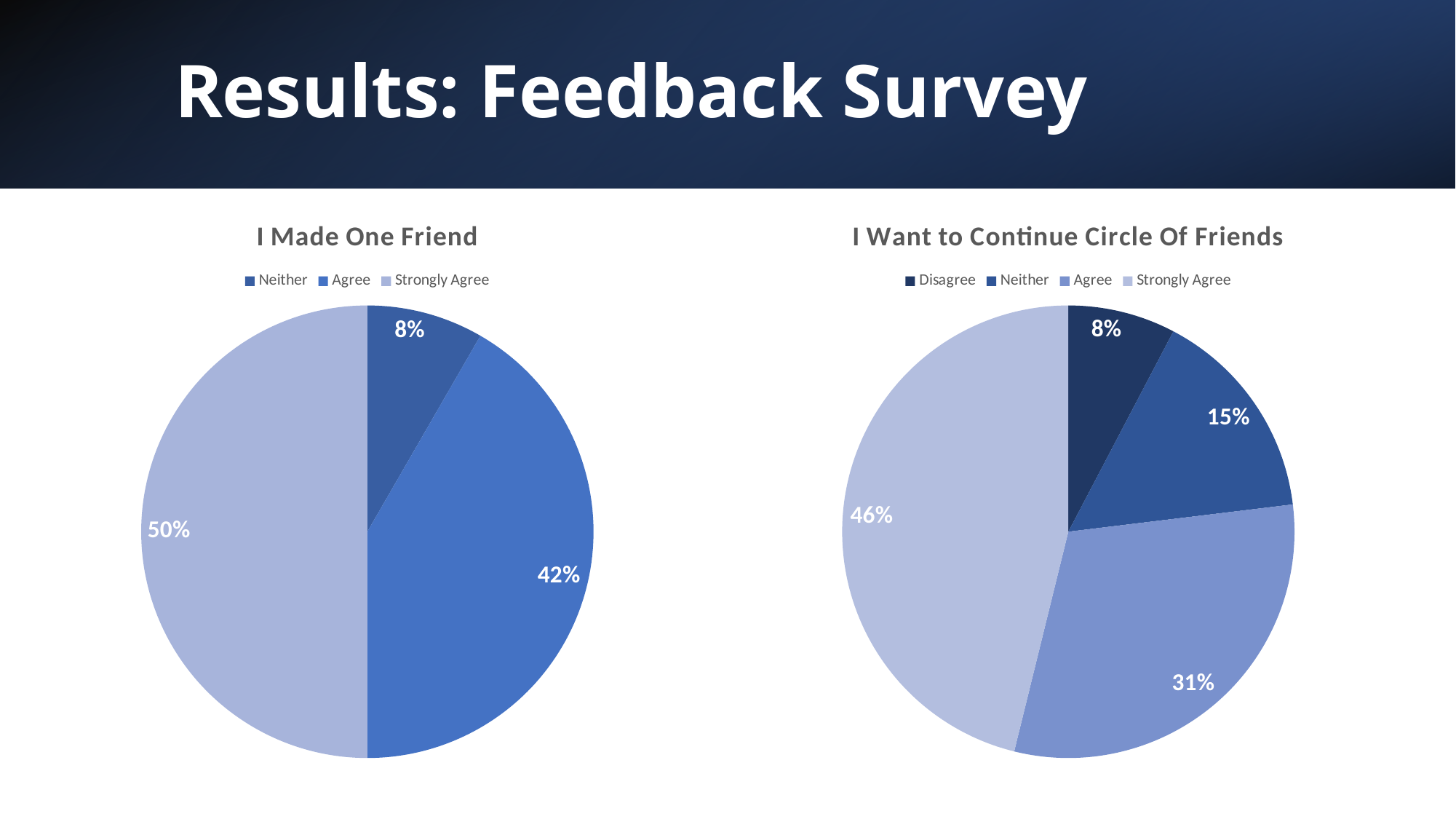
In the 'I Want to Continue Circle Of Friends' chart, which is larger: the share for Neither or the share for Disagree? Neither In the 'I Made One Friend' chart, what percentage of respondents chose Agree? 42% In the 'I Made One Friend' chart, what percentage of respondents chose Neither? 8% What type of chart is the 'I Made One Friend' chart? Pie chart In the 'I Want to Continue Circle Of Friends' chart, what is the difference in percentage points between Strongly Agree and Agree? 15 In the 'I Made One Friend' chart, what percentage of respondents chose Strongly Agree? 50% In the 'I Want to Continue Circle Of Friends' chart, what percentage of respondents chose Neither? 15% How many categories does the legend of the 'I Want to Continue Circle Of Friends' chart list? 4 In the 'I Want to Continue Circle Of Friends' chart, what percentage of respondents chose Agree? 31% In the 'I Want to Continue Circle Of Friends' chart, which response has the largest share? Strongly Agree In the 'I Made One Friend' chart, what is the difference in percentage points between Strongly Agree and Agree? 8 In the 'I Want to Continue Circle Of Friends' chart, which response has the smallest share? Disagree